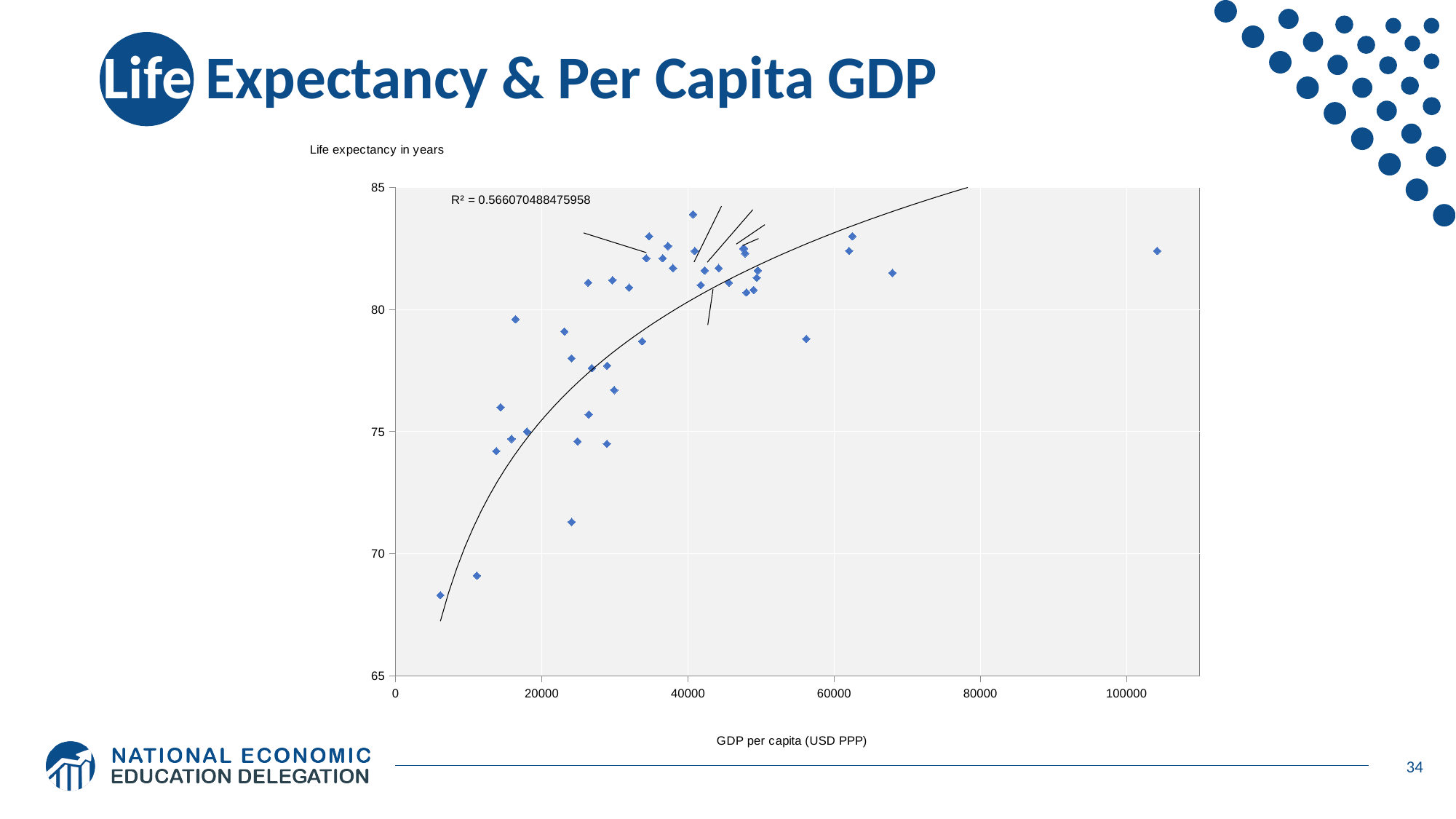
Is the life expectancy of the point with the highest GDP per capita greater or less than 80? greater Is the GDP per capita of the rightmost point greater or less than 100000? greater What is the highest value shown on the vertical axis? 85 What is the label of the horizontal axis? GDP per capita (USD PPP) Does life expectancy generally rise or fall as GDP per capita increases along the x axis? rise What is the label of the vertical axis? Life expectancy in years What is the highest tick label shown on the horizontal axis? 100000 What R² value is printed on the chart? R² = 0.566070488475958 Is the GDP per capita of the point with the lowest life expectancy greater or less than 20000? less What kind of chart is shown on the slide? scatter chart